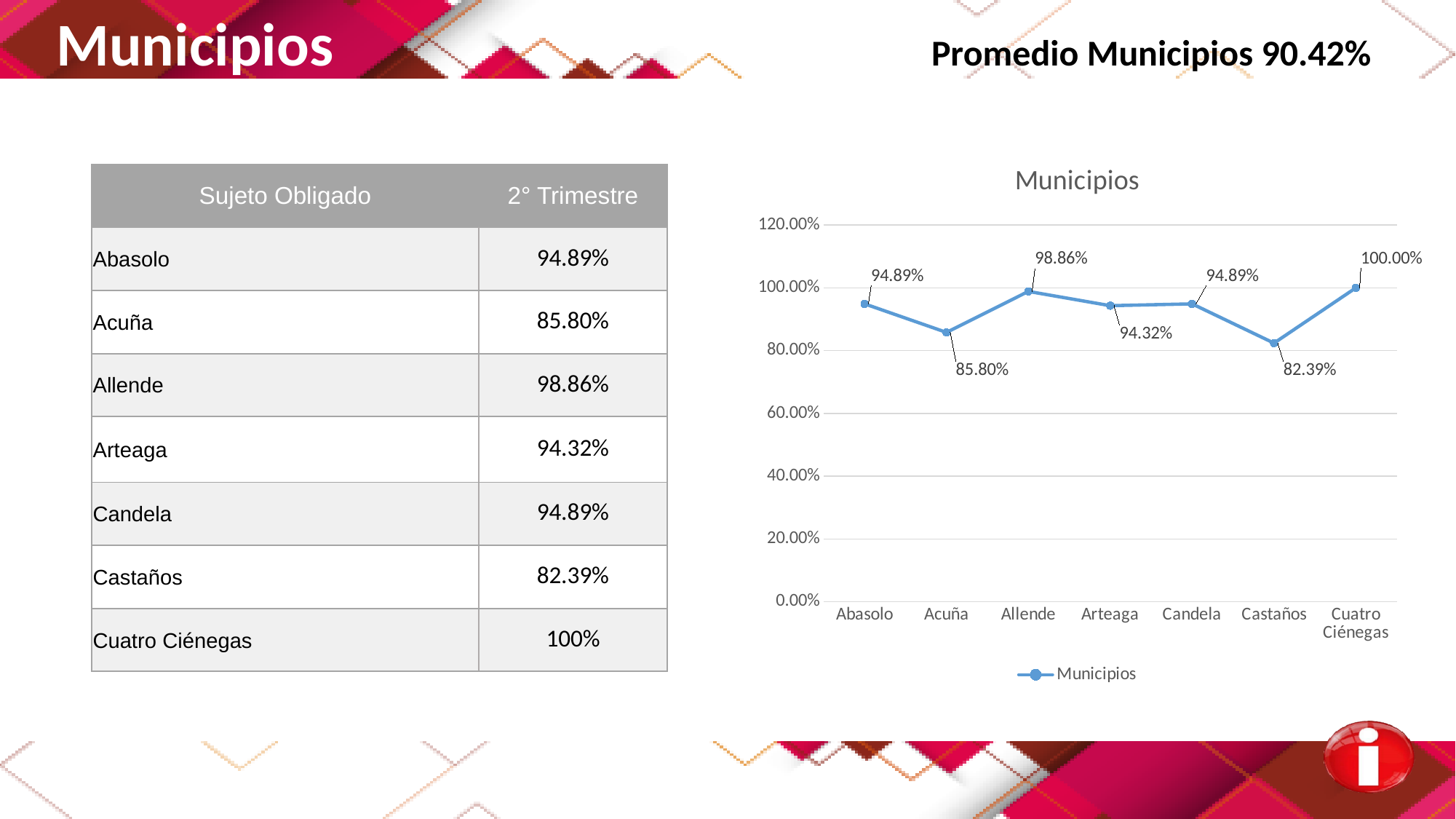
Which is larger in the Municipios chart, the value for Acuña or the value for Candela? Candela What is the difference between the values for Allende and Acuña in the Municipios chart? 13.06% What kind of chart is the Municipios chart? line chart What is the value for Arteaga in the Municipios chart? 94.32% Which municipality has the lowest value in the Municipios chart? Castaños How many municipalities are plotted in the Municipios chart? 7 What is the value for Allende in the Municipios chart? 98.86% Is the value for Castaños in the Municipios chart greater or less than 100.00%? less What is the difference between the values for Cuatro Ciénegas and Castaños in the Municipios chart? 17.61% What is the value for Castaños in the Municipios chart? 82.39% Which municipality has the highest value in the Municipios chart? Cuatro Ciénegas How many series does the legend of the Municipios chart list? 1